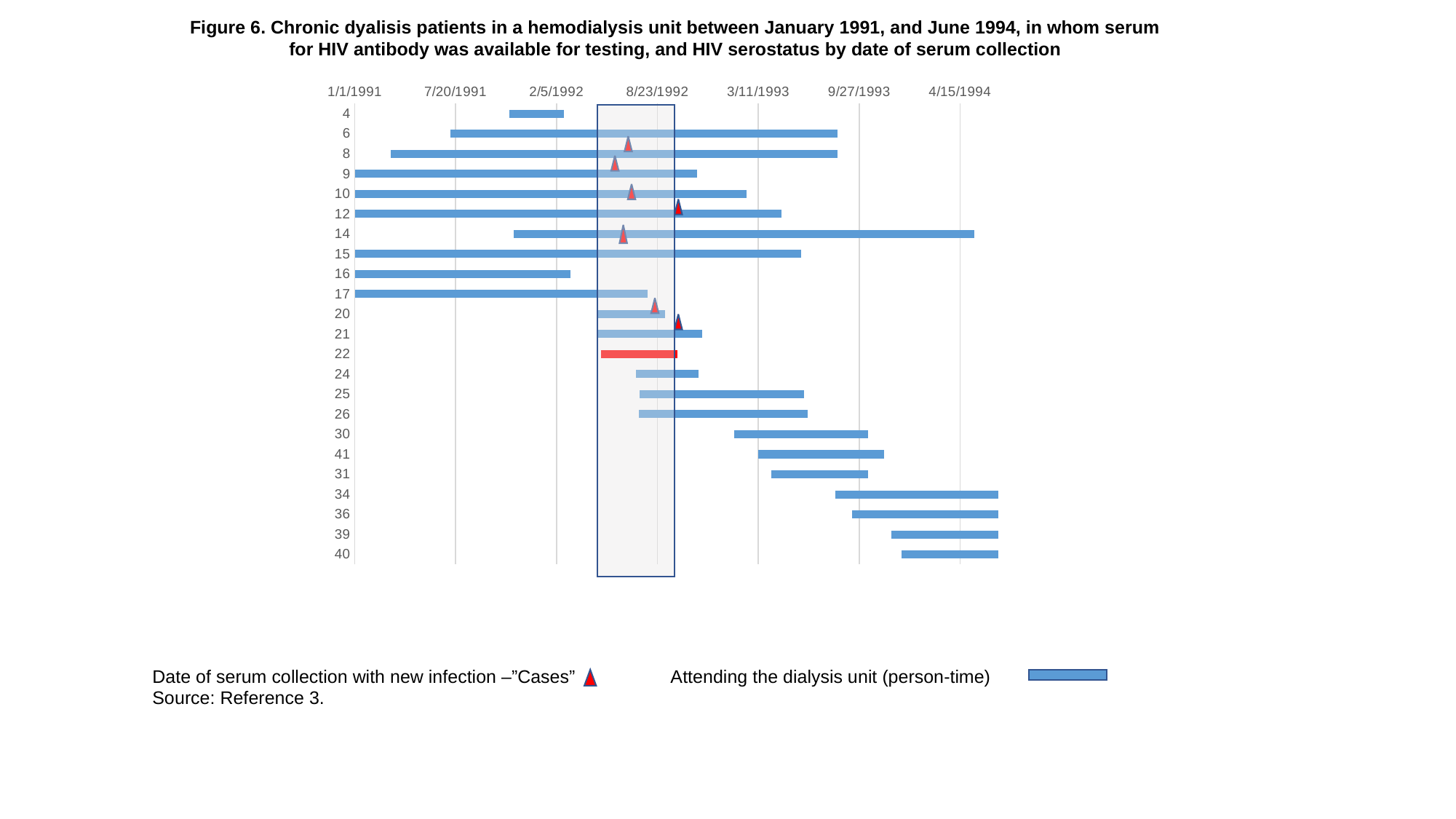
Does the bar for patient 39 start before or after 9/27/1993? after Does the bar for patient 30 start before or after 3/11/1993? before What is the first date label shown on the horizontal axis? 1/1/1991 How many entries does the legend below the chart list? 2 How many patients are listed on the vertical axis of the chart? 23 Does the bar for patient 4 end before or after 8/23/1992? before What kind of chart is shown on the slide? Bar chart Which patient's bar is drawn in red rather than blue? 22 How many red triangle markers (cases) are plotted on the chart? 7 Which bar starts earlier, the one for patient 4 or the one for patient 8? 8 Which bar ends later, the one for patient 6 or the one for patient 14? 14 What does the red triangle symbol in the legend represent? Date of serum collection with new infection – "Cases"